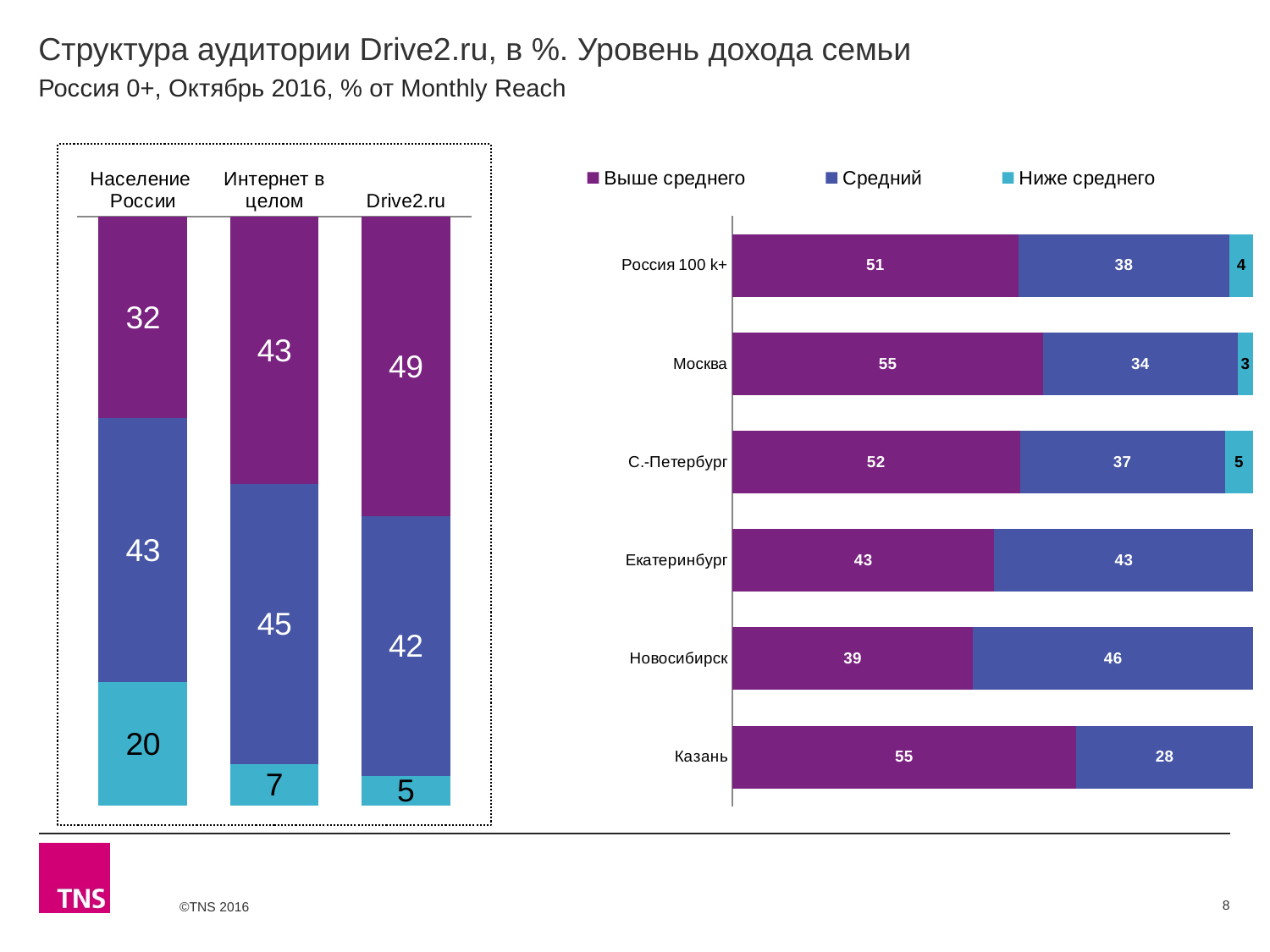
In the right chart, what is the total of the stacked bar for Россия 100 k+? 93 In the right chart, which city has the lowest Средний value? Казань What type of chart is the right chart? Stacked bar chart In the left chart, what is the value of the top (purple) segment for Drive2.ru? 49 In the left chart, what is the difference between the top (purple) segment values for Drive2.ru and Население России? 17 In the right chart, how many series does the legend list? 3 In the left chart, how many bars (categories) are shown? 3 In the left chart, what is the value of the bottom (light blue) segment for Население России? 20 In the right chart, what is the Выше среднего value for Москва? 55 In the left chart, what is the value of the middle (blue) segment for Интернет в целом? 45 In the right chart, what is the Ниже среднего value for С.-Петербург? 5 In the right chart, what is the Средний value for Новосибирск? 46